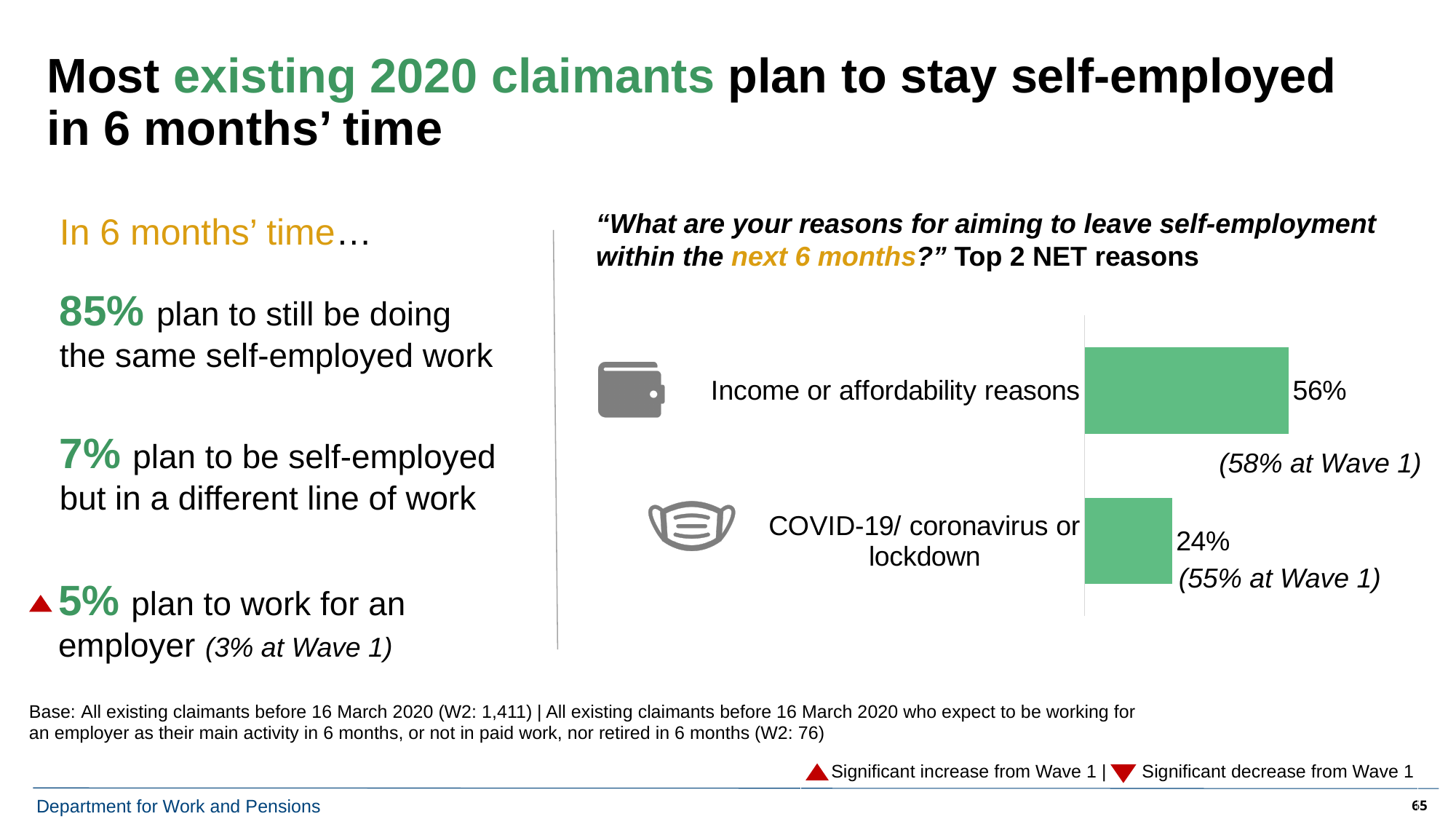
What is the difference between the values for Income or affordability reasons and COVID-19/ coronavirus or lockdown? 32 percentage points What was the Wave 1 value for Income or affordability reasons? 58% What is the value for COVID-19/ coronavirus or lockdown? 24% What was the Wave 1 value for COVID-19/ coronavirus or lockdown? 55% Which reason has the lowest value? COVID-19/ coronavirus or lockdown Which reason has the highest value? Income or affordability reasons How many reasons are plotted in the chart? 2 By how much did the value for COVID-19/ coronavirus or lockdown change from Wave 1 to the current wave? Fell by 31 percentage points What kind of chart is shown? Bar chart What colour are the bars in the chart? Green Which is larger: the value for Income or affordability reasons or the value for COVID-19/ coronavirus or lockdown? Income or affordability reasons What is the value for Income or affordability reasons? 56%